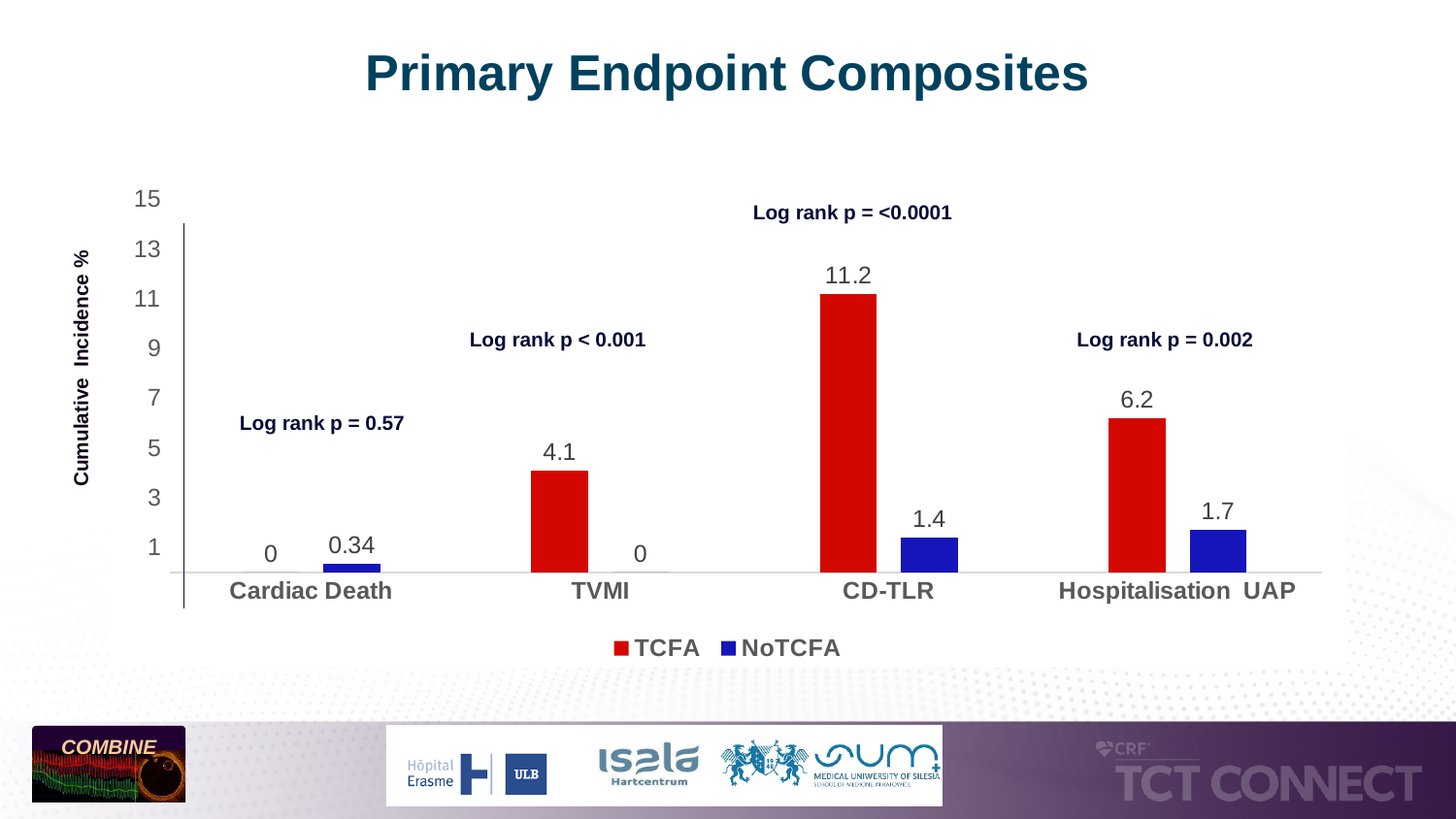
How many series does the legend list? 2 Which category has the highest TCFA value? CD-TLR How many categories are shown on the x axis? 4 Which is larger for Hospitalisation UAP, the TCFA value or the NoTCFA value? TCFA What is the title of the chart? Primary Endpoint Composites What is the TCFA value for CD-TLR? 11.2 What is the difference between the TCFA and NoTCFA values for CD-TLR? 9.8 Which category has the lowest NoTCFA value? TVMI What is the NoTCFA value for Cardiac Death? 0.34 What is the TCFA value for Hospitalisation UAP? 6.2 What is the NoTCFA value for TVMI? 0 What kind of chart is shown on the slide? Bar chart